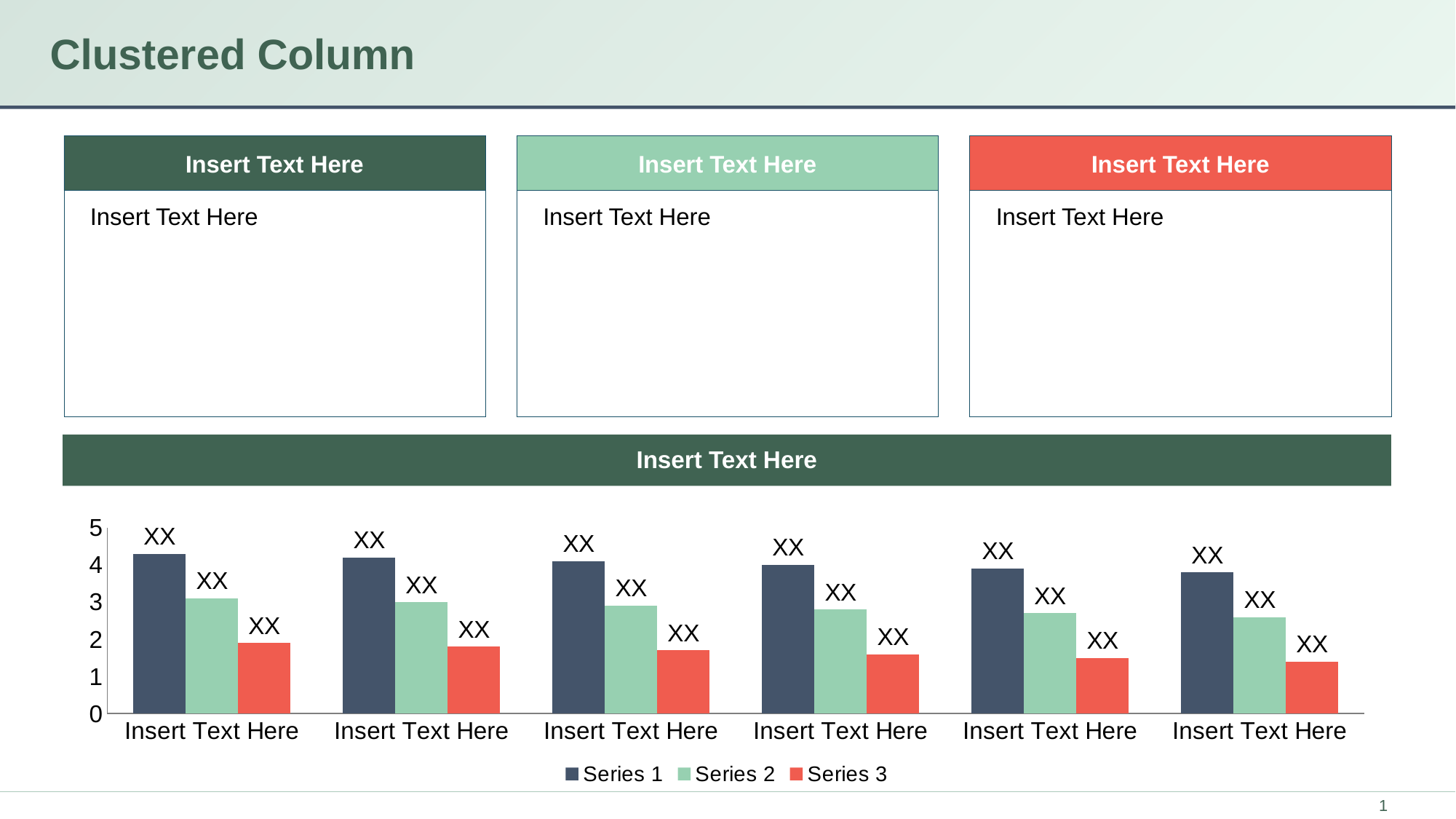
Is the value for Series 1 in the leftmost cluster greater or less than 4? greater What kind of chart is shown on the slide? bar chart In the rightmost cluster, is the bar for Series 1 larger or smaller than the bar for Series 3? larger In the leftmost cluster, which series has the shortest bar? Series 3 How many series does the chart legend list? 3 In the leftmost cluster, which series has the tallest bar? Series 1 What are the names of the series listed in the legend? Series 1, Series 2, Series 3 Is the value for Series 3 in the rightmost cluster greater or less than 2? less Do the Series 1 bars rise or fall moving from left to right across the clusters? fall How many category groups (clusters) are plotted along the x axis? 6 What is the highest value shown on the vertical axis? 5 Is the value for Series 2 in the rightmost cluster greater or less than 3? less